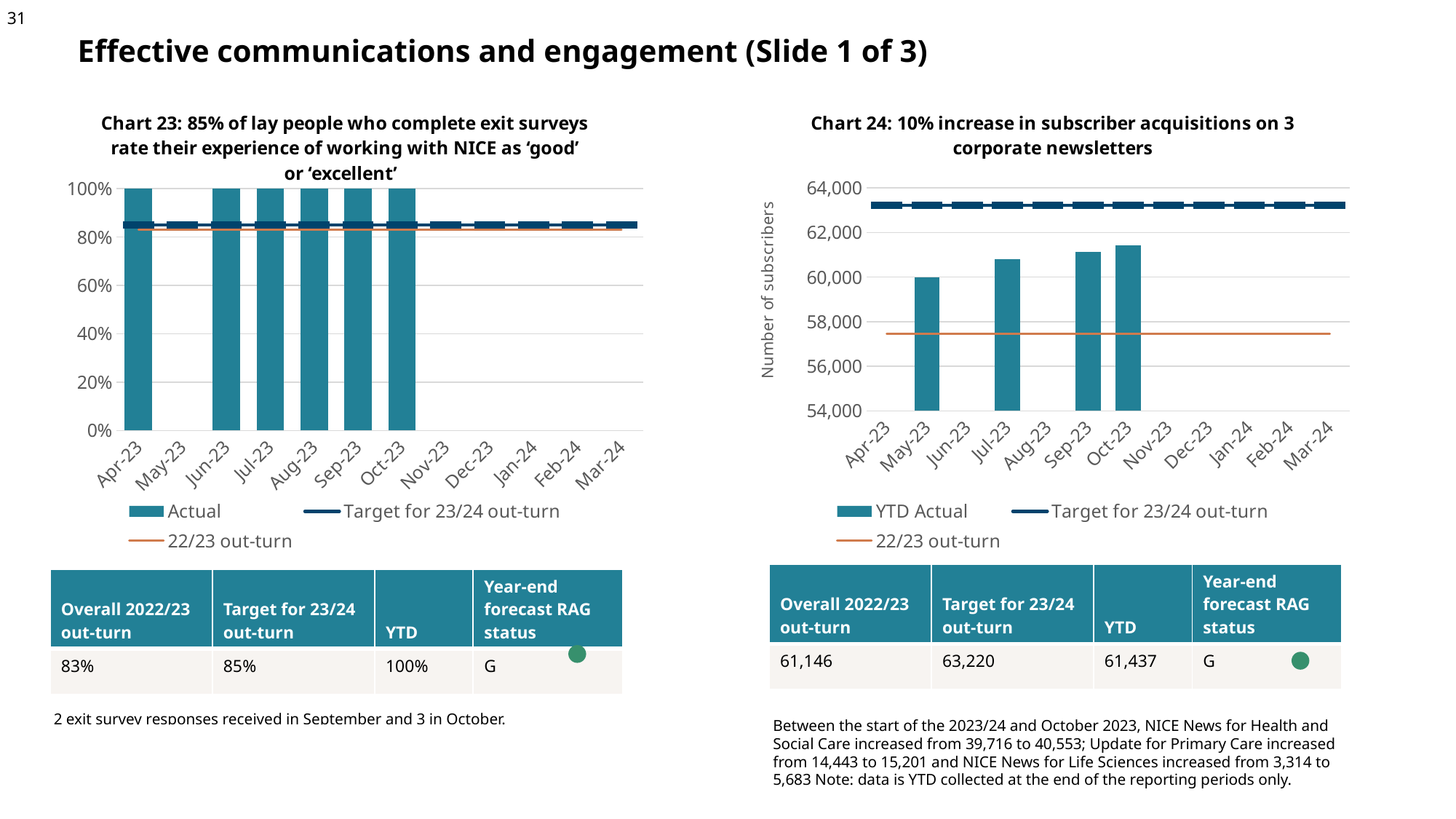
In Chart 23, what is the Actual value for Apr-23? 100% In Chart 24, which month has the lowest YTD Actual bar? May-23 In Chart 24, is the YTD Actual value for Oct-23 greater or less than 60,000? greater What kind of chart is Chart 24? bar chart In Chart 23, is the Actual value for Jun-23 greater or less than 80%? greater What is the y-axis label of Chart 24? Number of subscribers In Chart 24, do the YTD Actual bars rise or fall from May-23 to Oct-23? rise How many series does the legend of Chart 23 list? 3 How many series does the legend of Chart 24 list? 3 What kind of chart is Chart 23? bar chart In Chart 23, how many months have an Actual bar plotted? 6 How many months are shown on the x axis of Chart 23? 12